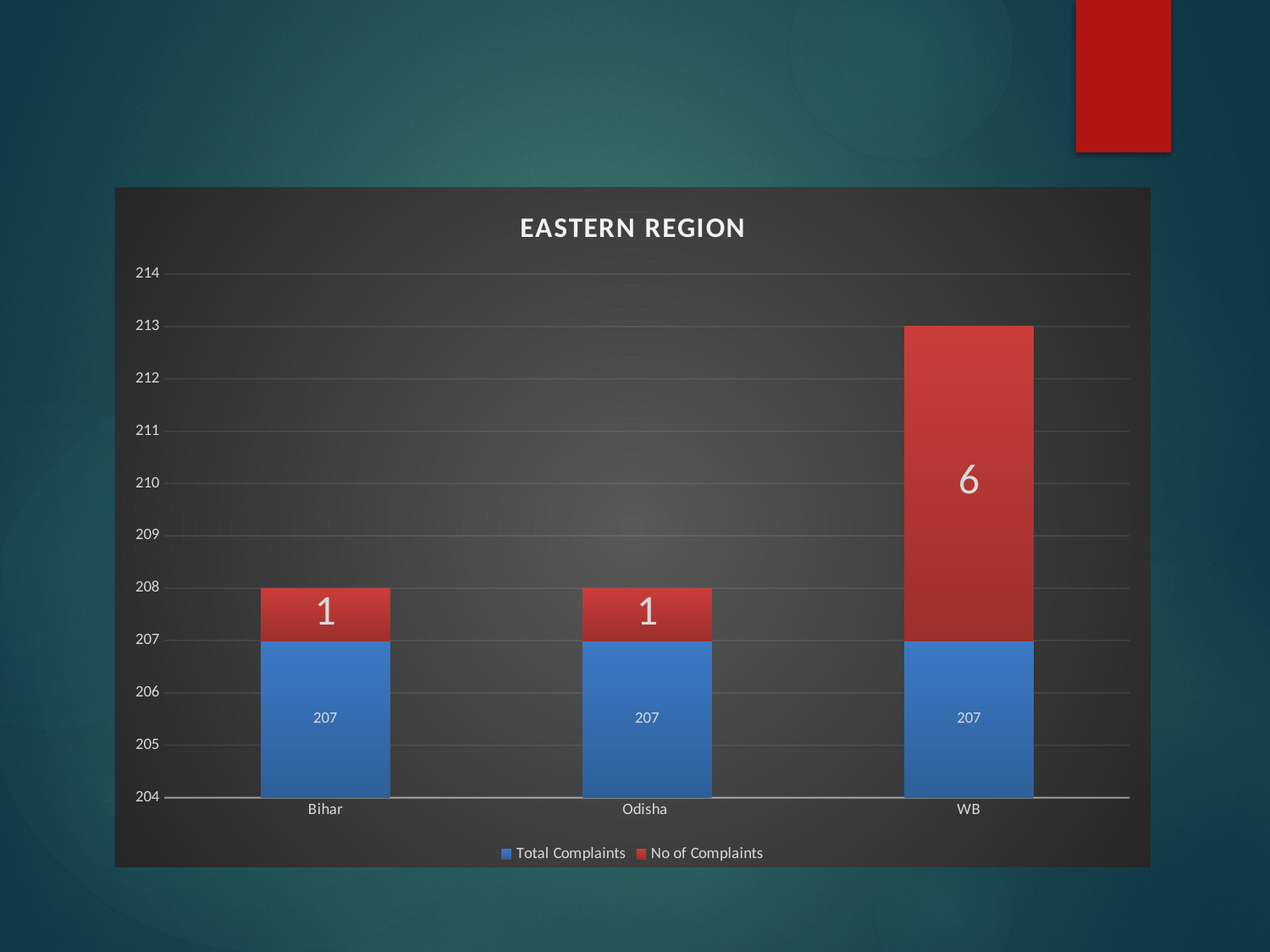
How many series does the legend list? 2 Which category has the highest No of Complaints? WB Is the No of Complaints value for WB larger than that for Bihar? Yes What is the No of Complaints value for WB? 6 What type of chart is shown on the slide? Stacked bar chart What is the total of the stacked bar for WB? 213 What is the difference in No of Complaints between WB and Odisha? 5 What is the No of Complaints value for Bihar? 1 What is the Total Complaints value for Odisha? 207 How many categories are shown on the x axis of the chart? 3 What is the title of the chart? EASTERN REGION Which series is shown in red in the chart? No of Complaints